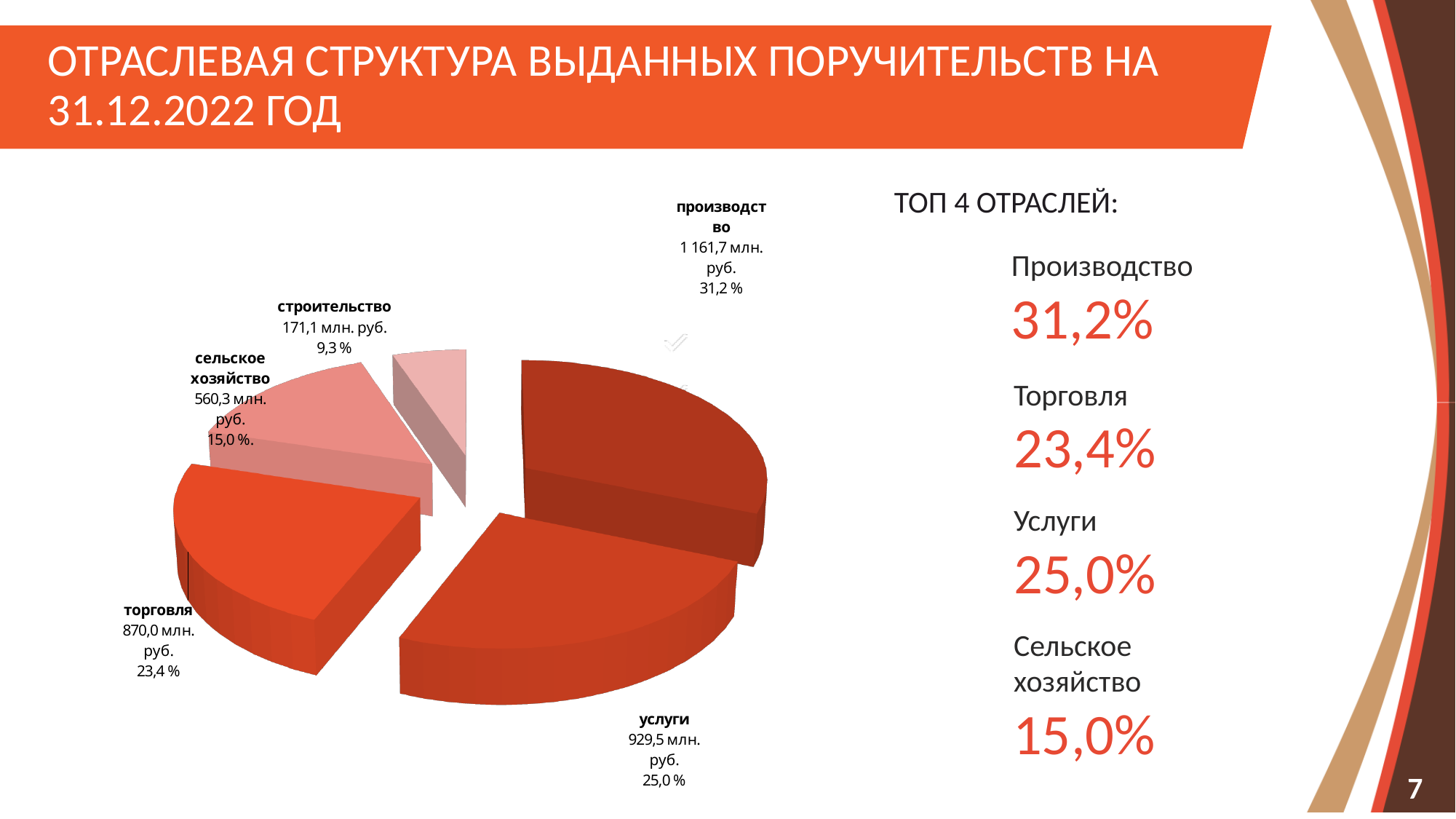
How many slices (categories) does the pie chart have? 5 What is the difference in value between производство and услуги? 232,2 млн. руб. Which is larger, услуги or торговля? услуги Which category has the smallest slice in the pie chart? строительство What share of the pie does торговля represent? 23,4 % What is the value for услуги in the pie chart? 929,5 млн. руб. What is the title of the slide containing the pie chart? ОТРАСЛЕВАЯ СТРУКТУРА ВЫДАННЫХ ПОРУЧИТЕЛЬСТВ НА 31.12.2022 ГОД Which category has the largest slice in the pie chart? производство What is the difference in value between сельское хозяйство and строительство? 389,2 млн. руб. What is the value for производство in the pie chart? 1 161,7 млн. руб. What share of the pie does строительство represent? 9,3 % What type of chart is shown on the slide? Pie chart